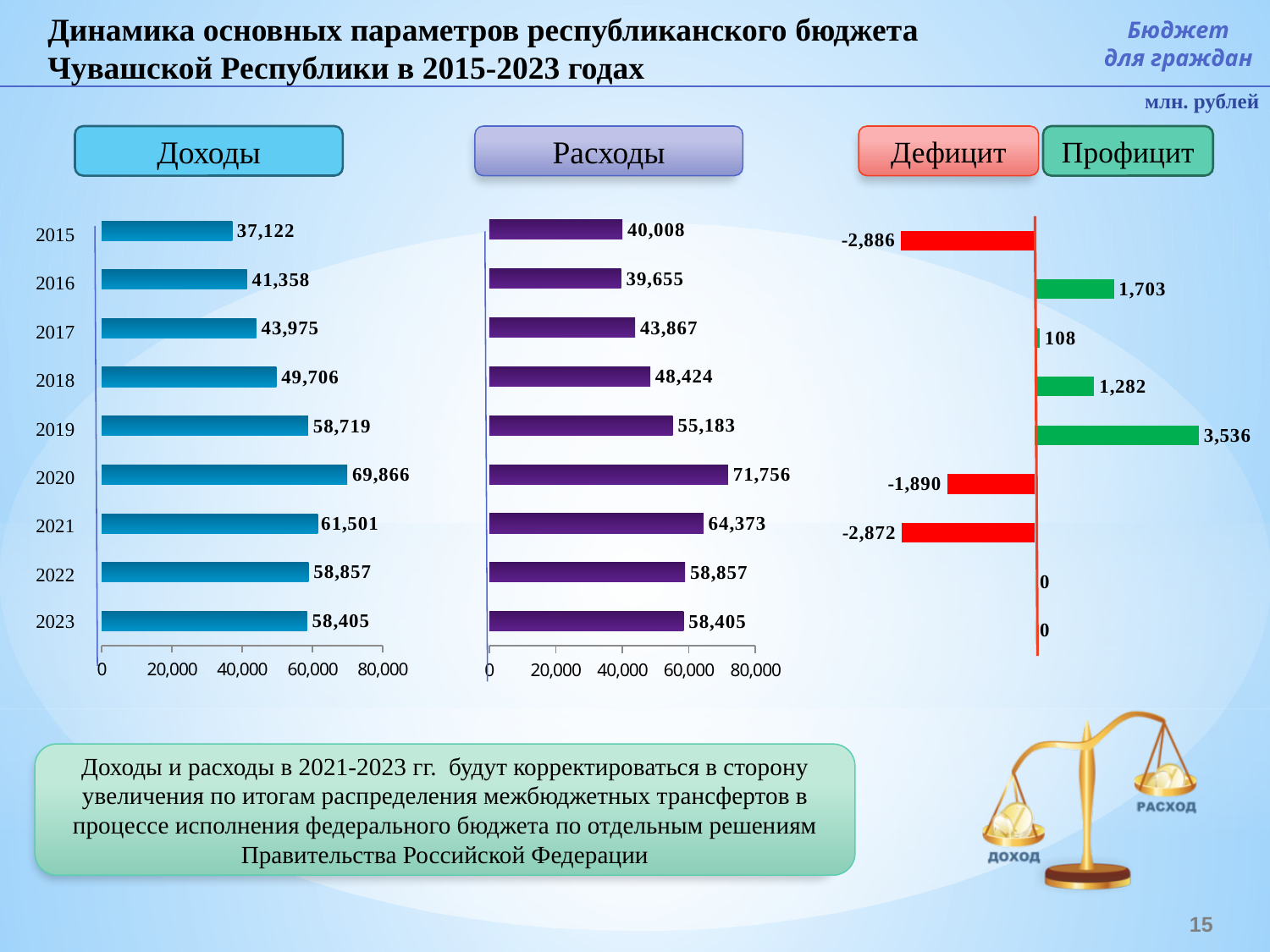
In the Доходы chart, which year has the highest value? 2020 In the Расходы chart, which year has the lowest value? 2016 In the Расходы chart, what is the value for 2020? 71,756 In the Дефицит/Профицит chart, which year has the largest deficit (most negative value)? 2015 In the Дефицит/Профицит chart, what colour are the deficit bars? red In the Доходы chart, is the value for 2018 greater or less than 40,000? greater In the Доходы chart, what is the value for 2015? 37,122 In the Расходы chart, which is larger, the value for 2021 or the value for 2018? 2021 How many years are shown in the Доходы chart? 9 In the Дефицит/Профицит chart, what is the value for 2019? 3,536 In the Доходы chart, what is the difference between the values for 2020 and 2019? 11,147 What type of chart is the Расходы chart? bar chart